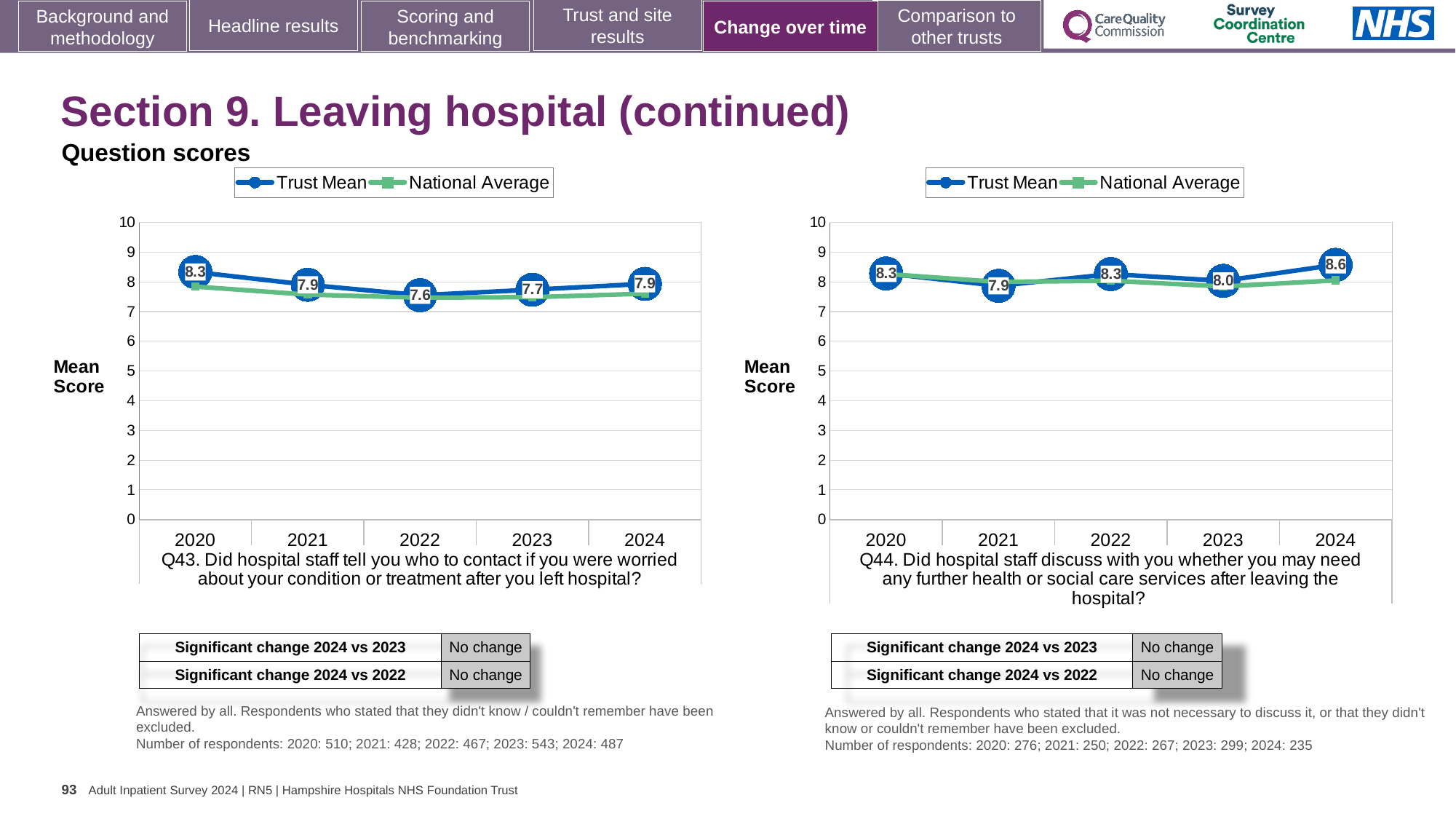
In the Q43 chart on the left, which year has the lowest Trust Mean score? 2022 In the Q43 chart on the left, how many years are plotted on the x axis? 5 What kind of chart is the Q43 chart on the left? line chart In the Q44 chart on the right, does the Trust Mean rise or fall from 2023 to 2024? rise In the Q44 chart on the right, which year has the highest Trust Mean score? 2024 In the Q43 chart on the left, what is the Trust Mean score for 2020? 8.3 In the Q44 chart on the right, what is the Trust Mean score for 2024? 8.6 In the Q43 chart on the left, is the Trust Mean score higher in 2021 or in 2023? 2021 How many series does the legend of the Q44 chart on the right list? 2 In the Q43 chart on the left, what is the difference between the Trust Mean scores for 2020 and 2022? 0.7 In the Q44 chart on the right, what is the difference between the Trust Mean scores for 2024 and 2023? 0.6 In the Q43 chart on the left, is the National Average for 2022 greater or less than 8? less